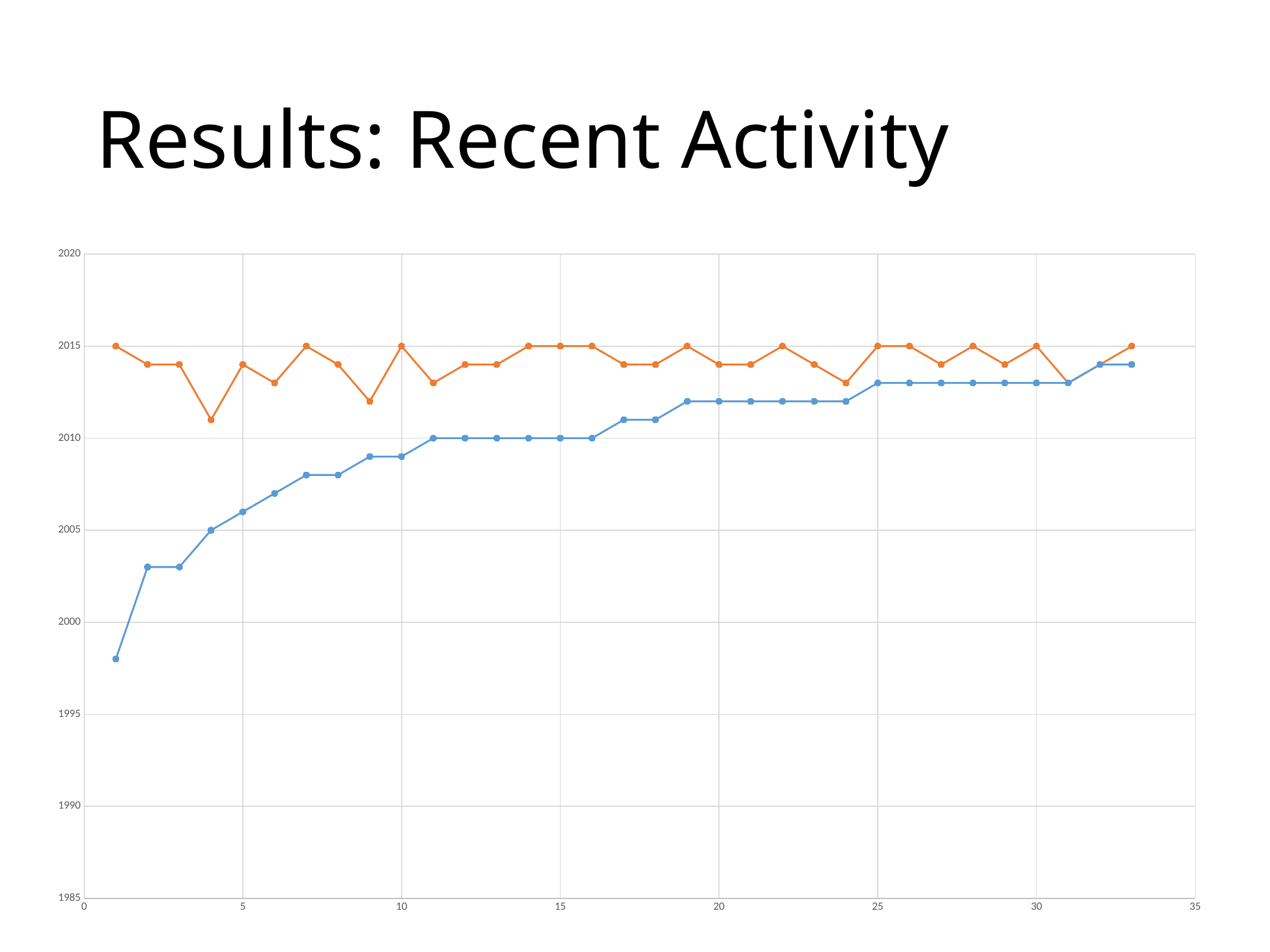
What is the title of the slide containing the chart? Results: Recent Activity Is the value of the blue series at x = 20 greater or less than 2010? greater At which x value does the orange series reach its lowest point? 4 What is the value of the orange series at x = 10? 2015 What is the value of the orange series at x = 1? 2015 How many lines (series) are plotted on the chart? 2 Is the value of the orange series at x = 4 greater or less than 2010? greater What kind of chart is shown on the slide? line chart Is the value of the blue series at x = 1 greater or less than 2000? less Does the blue series generally rise or fall as x increases? rise What is the value of the blue series at x = 11? 2010 At x = 1, which series has the higher value, blue or orange? orange